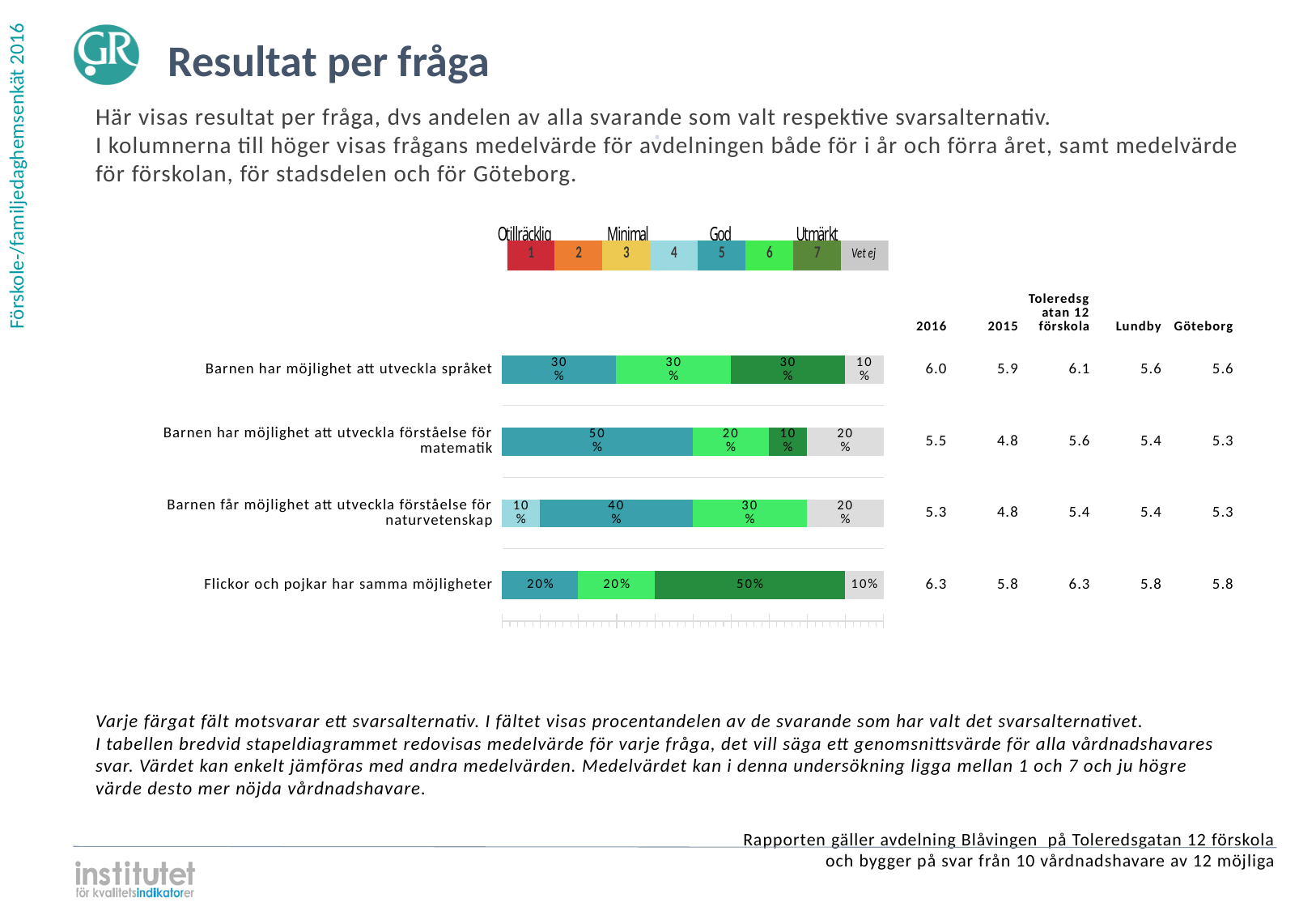
What is the total of the stacked bar for 'Barnen har möjlighet att utveckla språket' (30% + 30% + 30% + 10%)? 100% Which question has the smallest share of respondents choosing option 7 (dark green)? Barnen får möjlighet att utveckla förståelse för naturvetenskap How many questions (categories) are plotted in the bar chart? 4 What kind of chart is shown on the slide? Stacked bar chart Which is larger: the 'Vet ej' share for 'Barnen har möjlighet att utveckla språket' or for 'Barnen har möjlighet att utveckla förståelse för matematik'? Barnen har möjlighet att utveckla förståelse för matematik Which question has the largest share of respondents choosing option 7 (dark green)? Flickor och pojkar har samma möjligheter What percentage of respondents chose the dark green option 7 for 'Flickor och pojkar har samma möjligheter'? 50% What percentage of respondents answered 'Vet ej' for 'Barnen får möjlighet att utveckla förståelse för naturvetenskap'? 20% What percentage of respondents chose the teal option 5 for 'Barnen har möjlighet att utveckla förståelse för matematik'? 50% What label does the legend give to response option 7? Utmärkt What is the difference between the option 5 share for 'Barnen har möjlighet att utveckla förståelse för matematik' (50%) and for 'Flickor och pojkar har samma möjligheter' (20%)? 30 percentage points How many response options does the colour legend above the chart list? 8